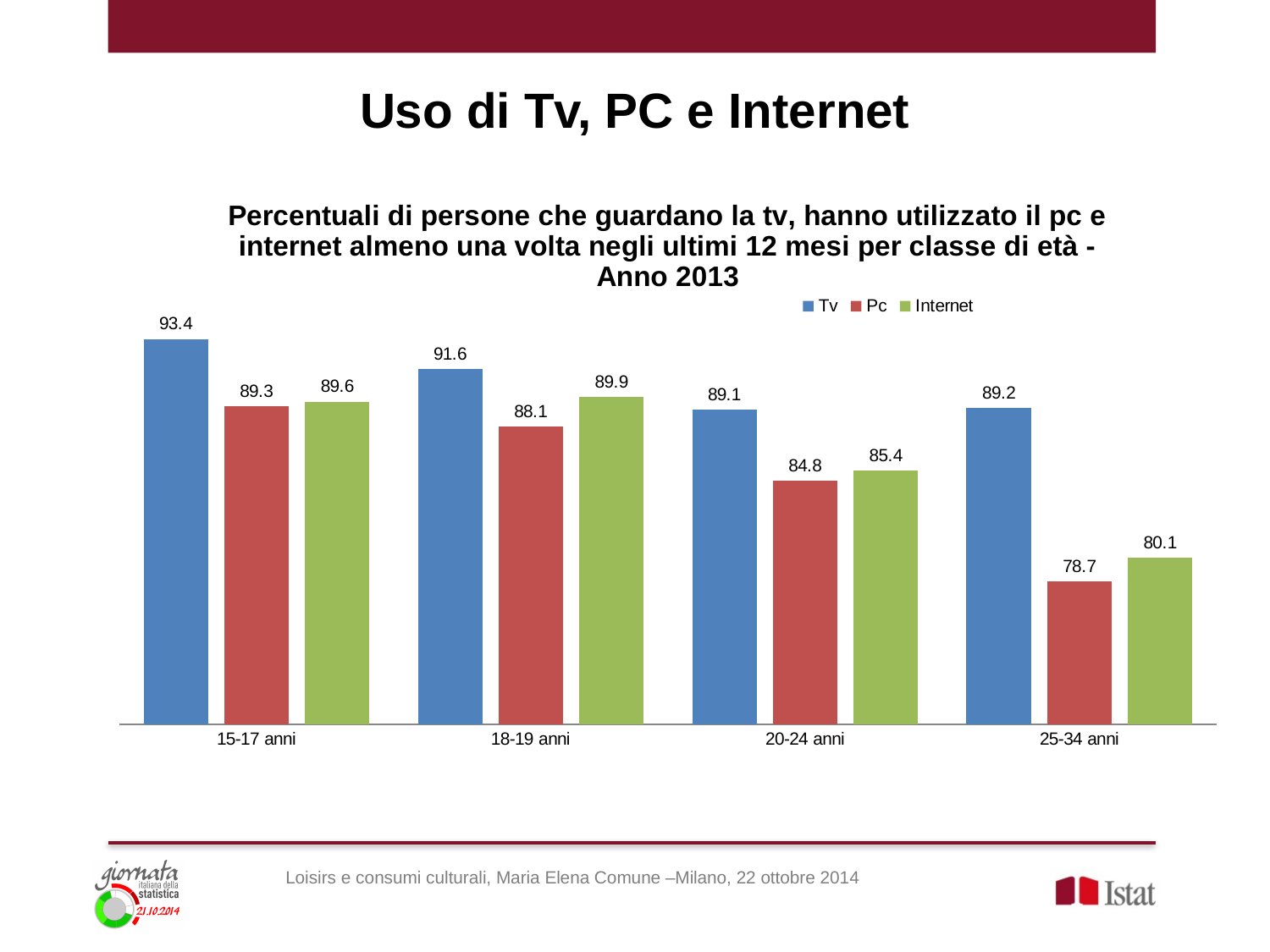
How many series does the legend list? 3 How many age groups are shown on the x axis? 4 Which series is shown in green in the legend? Internet Which age group has the highest Tv value? 15-17 anni What is the Pc value for the 25-34 anni age group? 78.7 Do the Pc values rise or fall from the 15-17 anni group to the 25-34 anni group? Fall What is the difference between the Tv and Pc values for the 20-24 anni age group? 4.3 Which age group has the lowest Internet value? 25-34 anni What is the Internet value for the 18-19 anni age group? 89.9 Which is larger for the 18-19 anni age group, the Pc value or the Internet value? Internet What is the Tv value for the 15-17 anni age group? 93.4 What kind of chart is shown on the slide? Bar chart